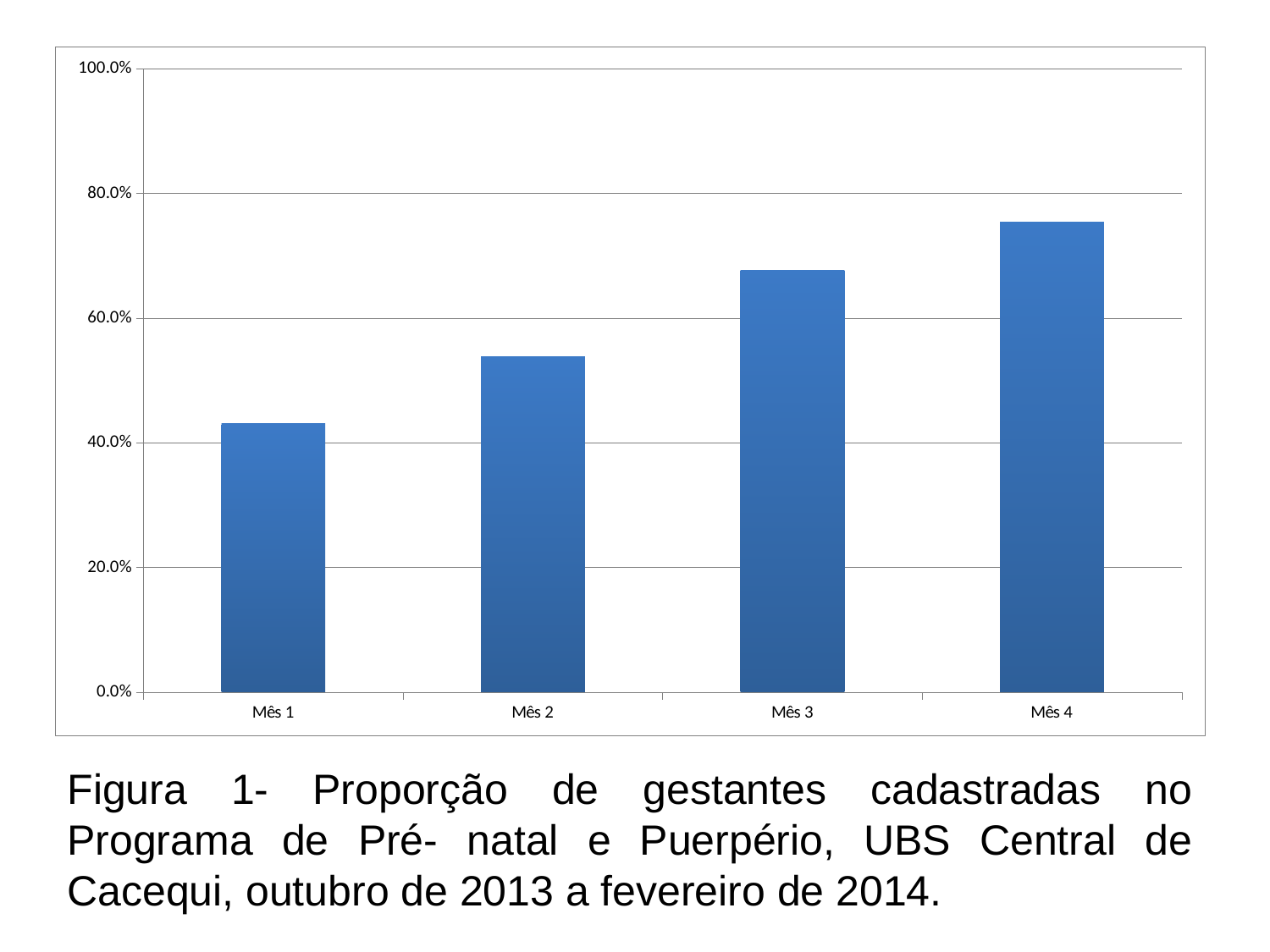
What kind of chart is shown on the slide? Bar chart Is the value for Mês 1 greater or less than 40.0%? greater Do the values rise or fall from Mês 1 to Mês 4? Rise Is the value for Mês 4 greater or less than 80.0%? less Is the value for Mês 3 greater or less than 60.0%? greater Which month has the lowest bar? Mês 1 What is the figure number given in the caption below the chart? Figura 1 Which is larger, the value for Mês 2 or the value for Mês 3? Mês 3 How many categories (months) are plotted on the x axis? 4 Which is larger, the value for Mês 1 or the value for Mês 4? Mês 4 Which month has the highest bar? Mês 4